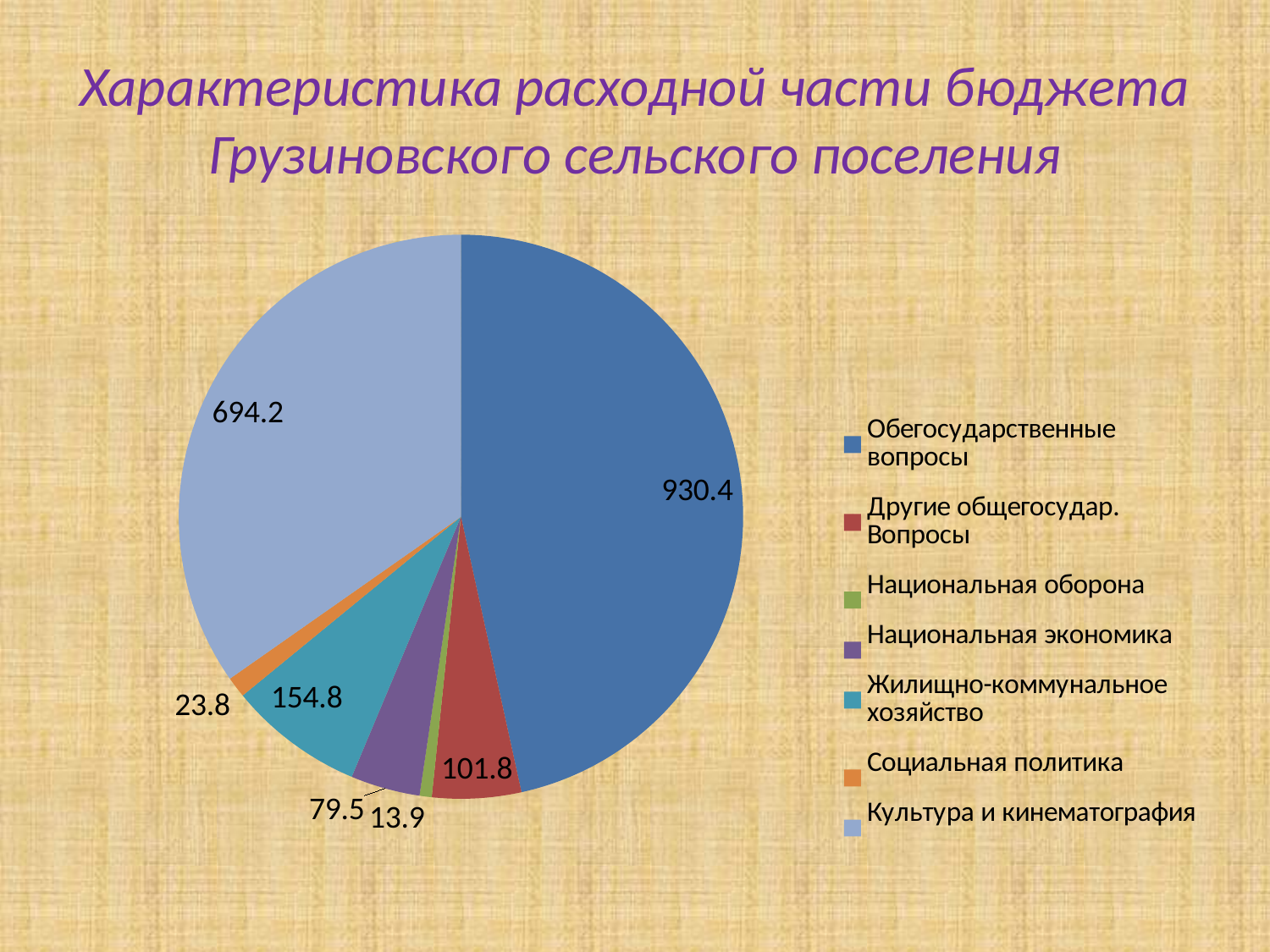
What is the value for Социальная политика? 23.8 What is the difference between the values for Обегосударственные вопросы and Культура и кинематография? 236.2 Which category has the largest slice? Обегосударственные вопросы What is the value for Жилищно-коммунальное хозяйство? 154.8 Which category has the smallest slice? Национальная оборона How many slices does the pie chart have? 7 How many entries does the legend list? 7 What is the value for Культура и кинематография? 694.2 Which is larger, Другие общегосудар. Вопросы or Национальная экономика? Другие общегосудар. Вопросы What type of chart is shown on the slide? pie chart What is the value for Национальная оборона? 13.9 What colour is the slice for Культура и кинематография? light blue